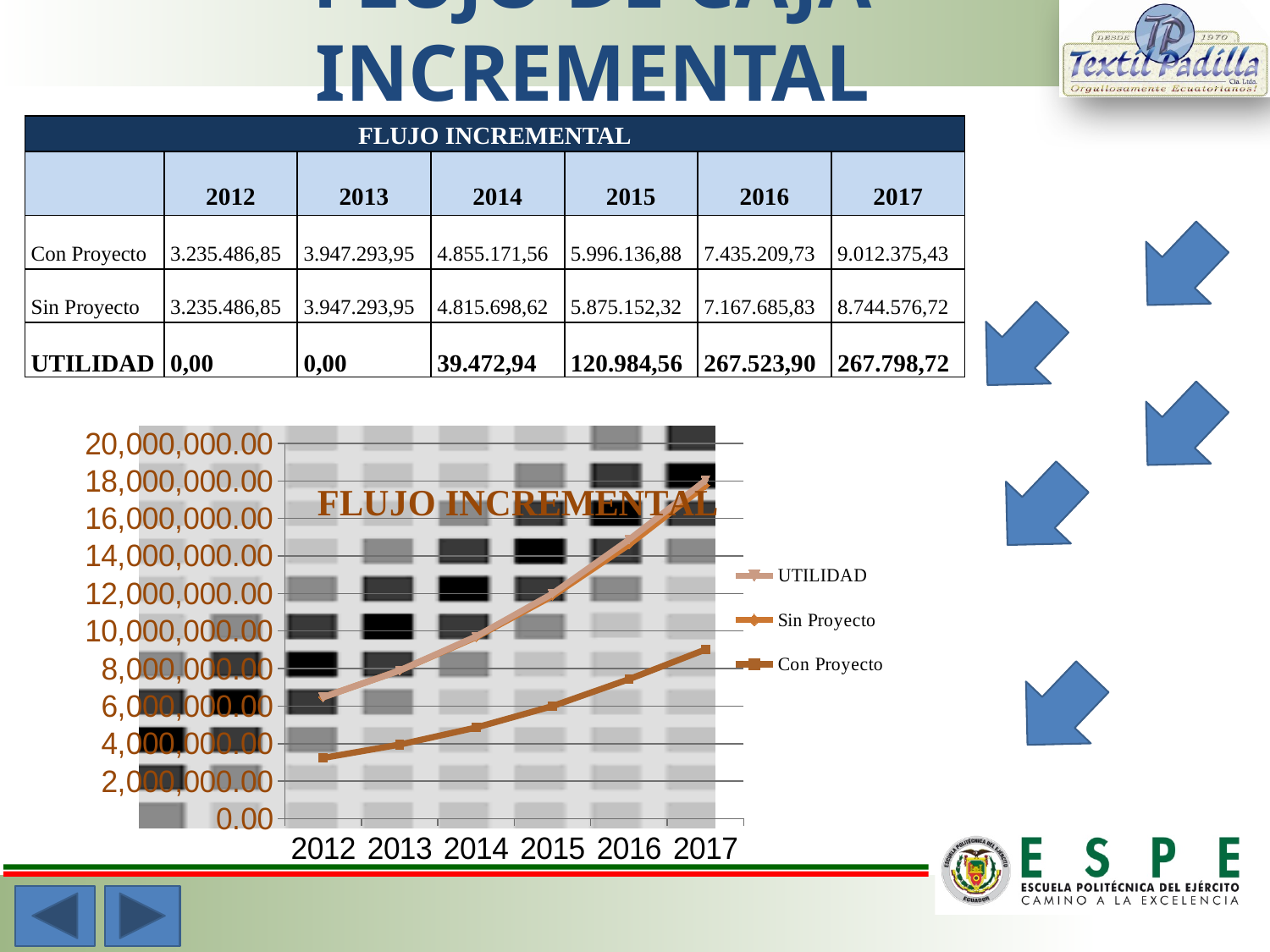
What is the title of the chart? FLUJO INCREMENTAL In the chart, is the plotted top line (UTILIDAD) in 2017 greater or less than 16,000,000.00? greater Does the Con Proyecto line rise or fall from 2012 to 2017? rise How many years are shown on the x axis of the chart? 6 What kind of chart is shown on the slide? line chart How many series does the chart legend list? 3 In the chart, is the plotted value for Con Proyecto in 2012 greater or less than 4,000,000.00? less In the chart, is the plotted value for Con Proyecto in 2017 greater or less than 8,000,000.00? greater In which year does the Con Proyecto line reach its highest point? 2017 According to the FLUJO INCREMENTAL table, what is the UTILIDAD value for 2017? 267.798,72 What are the entries in the chart legend? UTILIDAD, Sin Proyecto, Con Proyecto